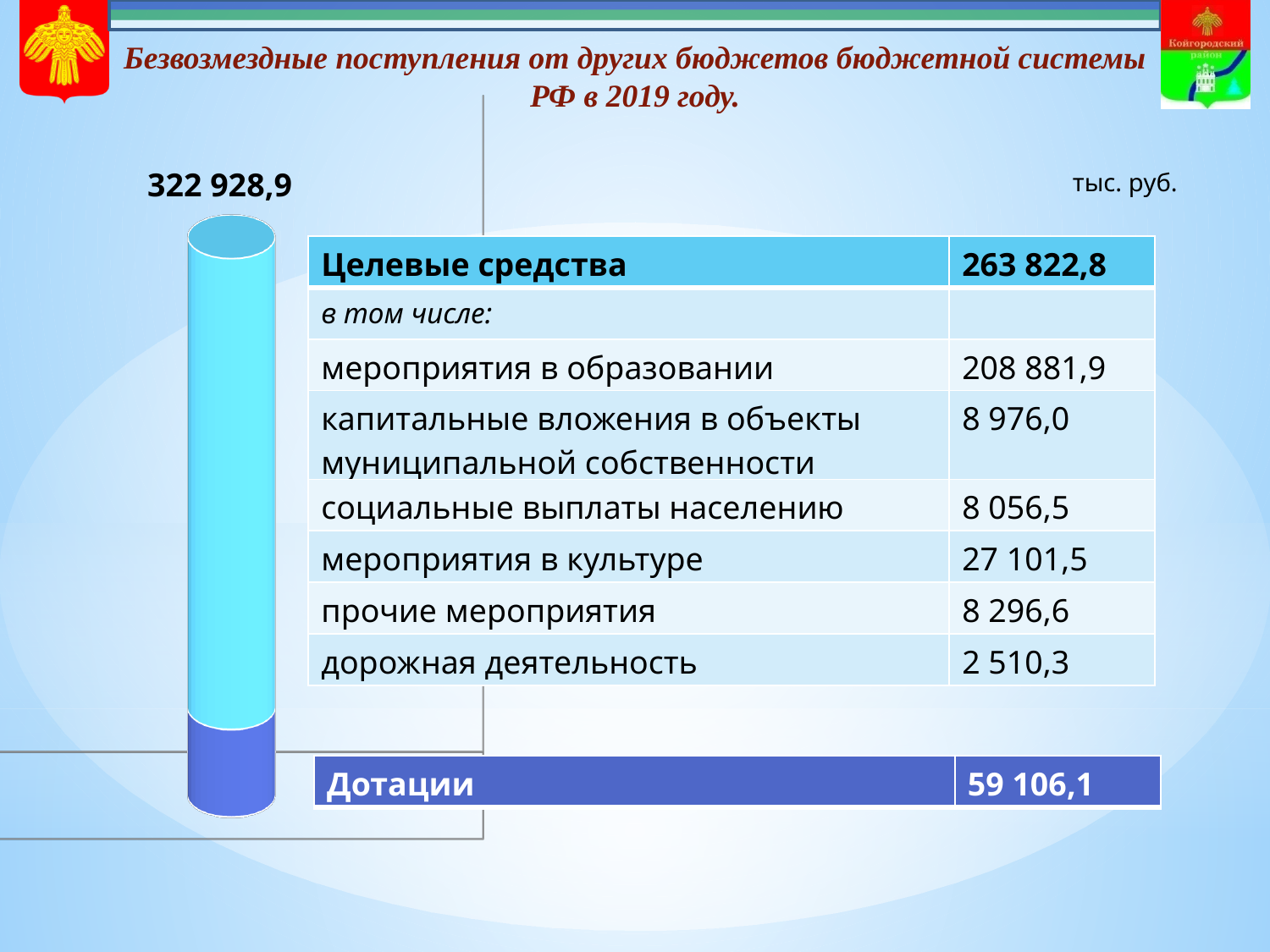
Within Целевые средства, what is the value for мероприятия в образовании? 208 881,9 What is the value of the Целевые средства segment of the bar? 263 822,8 Within Целевые средства, what is the value for дорожная деятельность? 2 510,3 What colour is the Дотации segment at the bottom of the bar? dark blue What is the difference between the Целевые средства and Дотации values? 204 716,7 What is the total value shown at the top of the stacked bar? 322 928,9 How many segments does the stacked bar have? 2 What kind of chart is shown on the slide? bar chart Which segment of the bar is larger, Целевые средства or Дотации? Целевые средства In what units are the values on the slide given? тыс. руб. What is the value of the Дотации segment of the bar? 59 106,1 Which segment of the bar is the smallest? Дотации